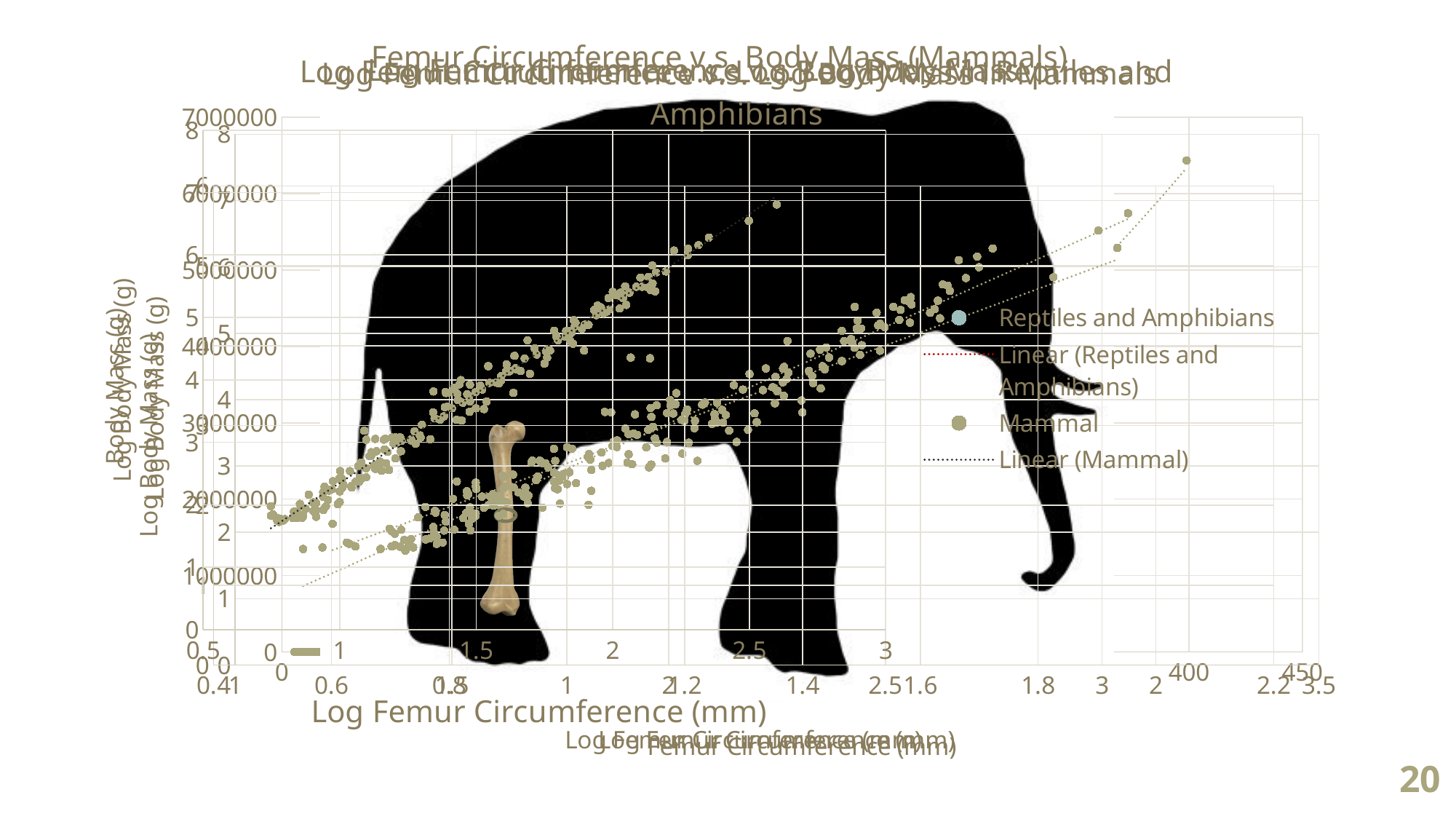
Which legend entry represents the fitted line for the Mammal series? Linear (Mammal) In the scatter chart, do the plotted body mass values generally rise or fall as femur circumference increases along the x axis? rise How many entries does the legend list? 4 Which legend entry is shown with a light blue marker? Reptiles and Amphibians What kind of chart is shown on the slide? scatter chart